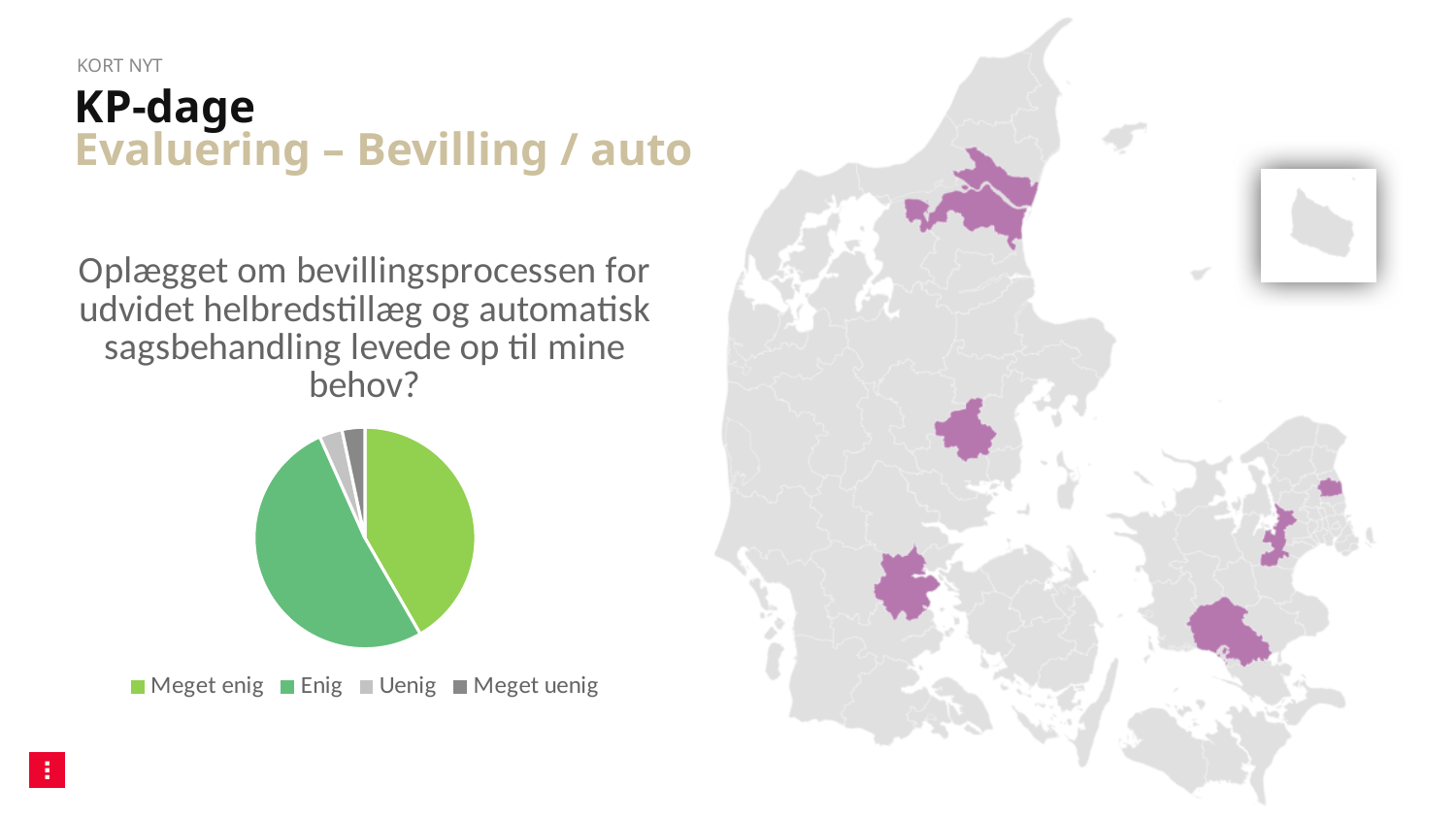
What is the first entry listed in the pie chart's legend? Meget enig Which slice is larger in the pie chart, Enig or Uenig? Enig What kind of chart is shown on the slide? Pie chart What is the last entry listed in the pie chart's legend? Meget uenig Which slice is larger in the pie chart, Meget enig or Uenig? Meget enig How many slices does the pie chart have? 4 Which slice is larger in the pie chart, Enig or Meget uenig? Enig How many entries does the legend of the pie chart list? 4